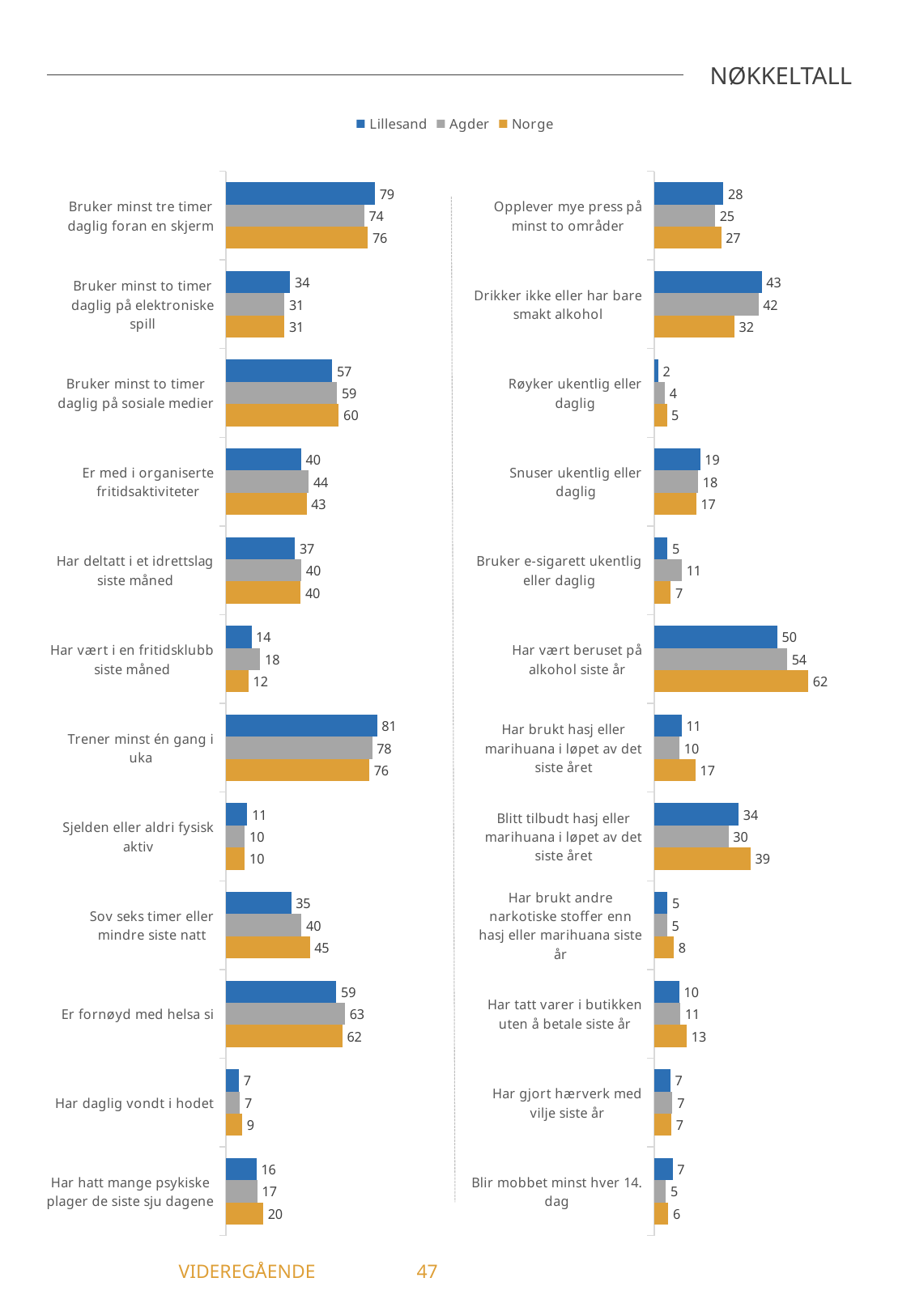
In the right chart, which is larger for "Drikker ikke eller har bare smakt alkohol": the Lillesand value or the Norge value? Lillesand How many series does the legend list? 3 In the left chart, what is the Lillesand value for "Bruker minst tre timer daglig foran en skjerm"? 79 In the left chart, which is larger for "Har vært i en fritidsklubb siste måned": the Agder value or the Norge value? Agder In the left chart, which category has the highest Lillesand value? Trener minst én gang i uka Which colour represents Norge in the legend? Orange What kind of chart is used on this slide? Bar chart In the right chart, which category has the lowest Lillesand value? Røyker ukentlig eller daglig How many categories are shown in the right chart? 12 In the right chart, what is the Norge value for "Har vært beruset på alkohol siste år"? 62 In the left chart, what is the Agder value for "Sov seks timer eller mindre siste natt"? 40 In the right chart, what is the difference between the Norge and Lillesand values for "Har brukt hasj eller marihuana i løpet av det siste året"? 6